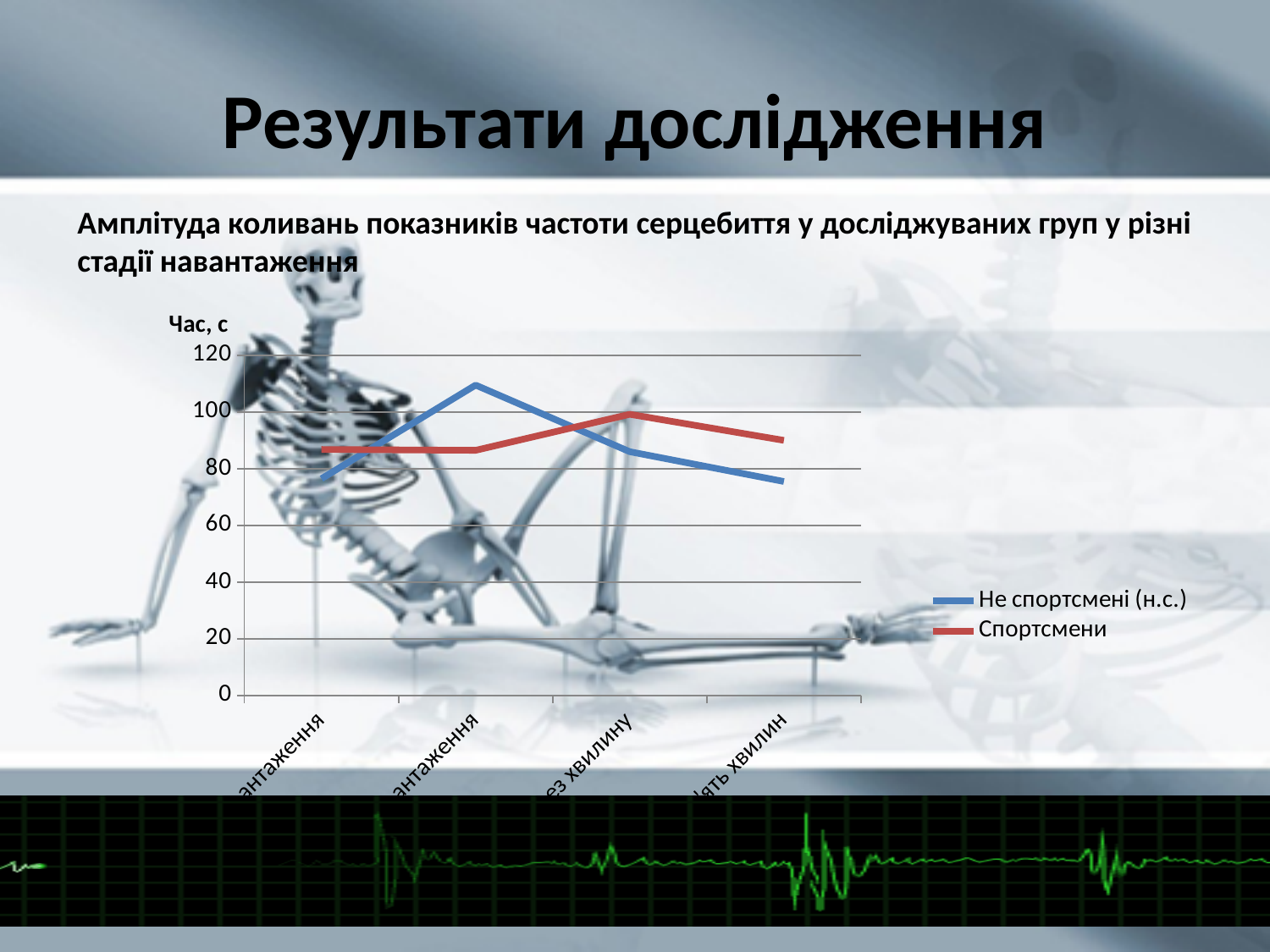
Is the value of the second point of the Не спортсмені (н.с.) line greater or less than 100? greater What are the two series named in the chart legend? Не спортсмені (н.с.) and Спортсмени What kind of chart is shown on the slide? line chart At the second point along the x axis, which series has the higher value? Не спортсмені (н.с.) Is the value of the third point of the Спортсмени line greater or less than 80? greater How many data points does each line in the chart have? 4 What is the title shown on the vertical axis of the chart? Час, с Which series reaches the highest value anywhere on the chart? Не спортсмені (н.с.) Is the value of the last point of the Не спортсмені (н.с.) line greater or less than 80? less From the second point to the last point, does the Не спортсмені (н.с.) line rise or fall? fall At the last point along the x axis, which series has the higher value? Спортсмени How many series does the chart legend list? 2